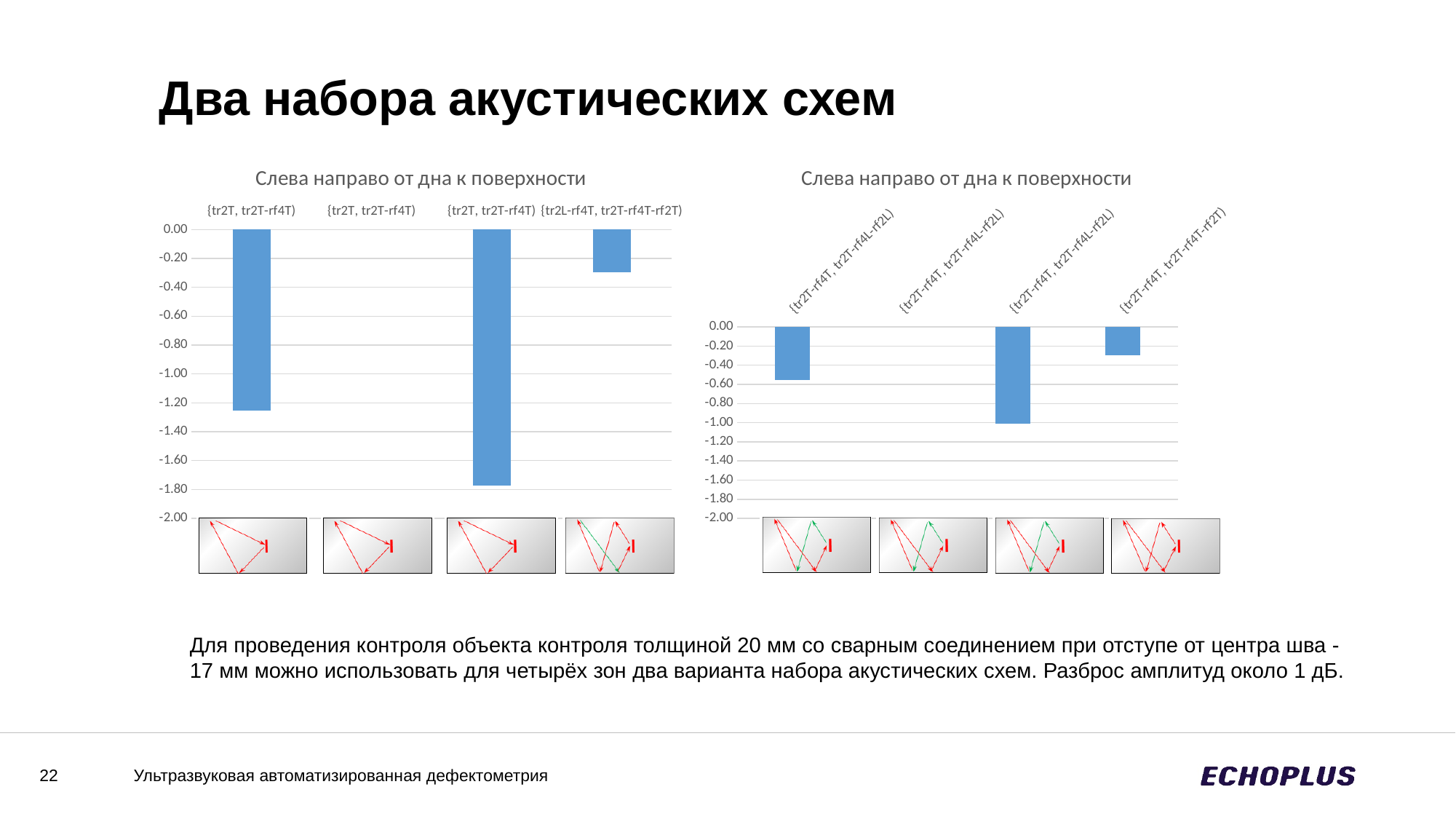
In the left chart, is the value for the first category greater or less than -1.00? less In the left chart, is the value for the fourth category {tr2L-rf4T, tr2T-rf4T-rf2T} greater or less than -0.40? greater In the right chart, which bar extends further below zero: the first category or the fourth category? the first category In the right chart, which category has the lowest (most negative) value? the third category What kind of chart is the left chart on the slide? bar chart How many categories does the right chart show? 4 What is the title of the left chart? Слева направо от дна к поверхности In the left chart, which category has the lowest (most negative) value? the third category In the right chart, is the value for the first category greater or less than -0.80? greater How many categories does the left chart show? 4